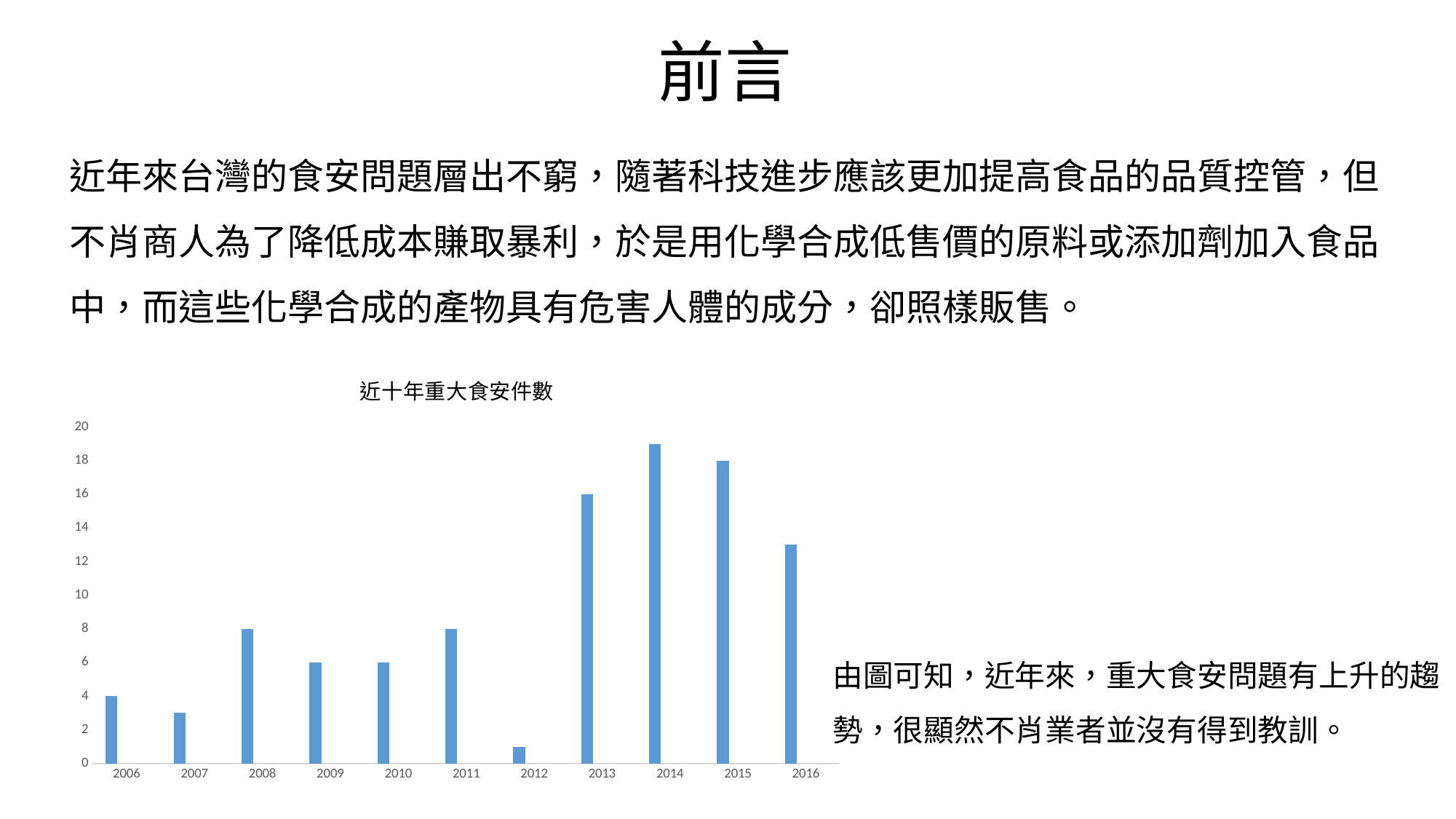
What is the value for 2008? 8 Is the value for 2014 greater or less than 18? greater What is the value for 2013? 16 What type of chart is shown on the slide? bar chart What is the title of the chart? 近十年重大食安件數 How many years are shown on the x axis of the chart? 11 Which year has the highest number of major food safety incidents? 2014 What is the difference between the values for 2013 and 2006? 12 Which is larger, the value for 2013 or the value for 2011? 2013 Which year has the lowest number of major food safety incidents? 2012 Is the value for 2016 greater or less than 12? greater What is the value for 2006? 4